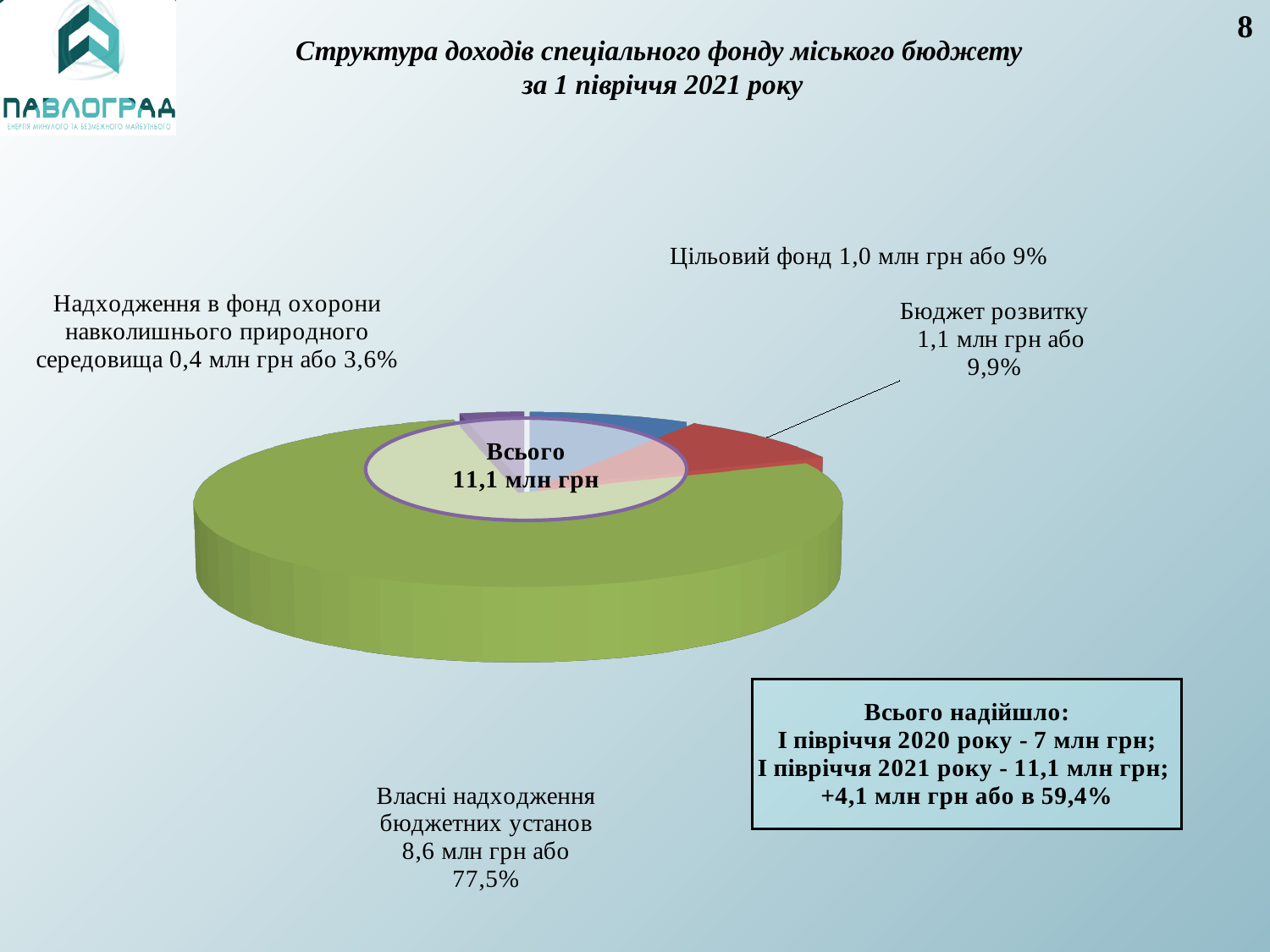
Which category has the smallest slice of the pie? Надходження в фонд охорони навколишнього природного середовища How many slices does the pie chart have? 4 Which category has the largest slice of the pie? Власні надходження бюджетних установ What share of the pie does Власні надходження бюджетних установ represent? 77,5% What share of the pie does Надходження в фонд охорони навколишнього природного середовища represent? 3,6% What kind of chart is shown on the slide? pie chart What is the value for Бюджет розвитку? 1,1 млн грн What is the value for Цільовий фонд? 1,0 млн грн What is the total shown in the centre of the pie chart? 11,1 млн грн What is the value for Власні надходження бюджетних установ? 8,6 млн грн What is the difference in млн грн between Бюджет розвитку and Цільовий фонд? 0,1 млн грн What share of the pie does Бюджет розвитку represent? 9,9%